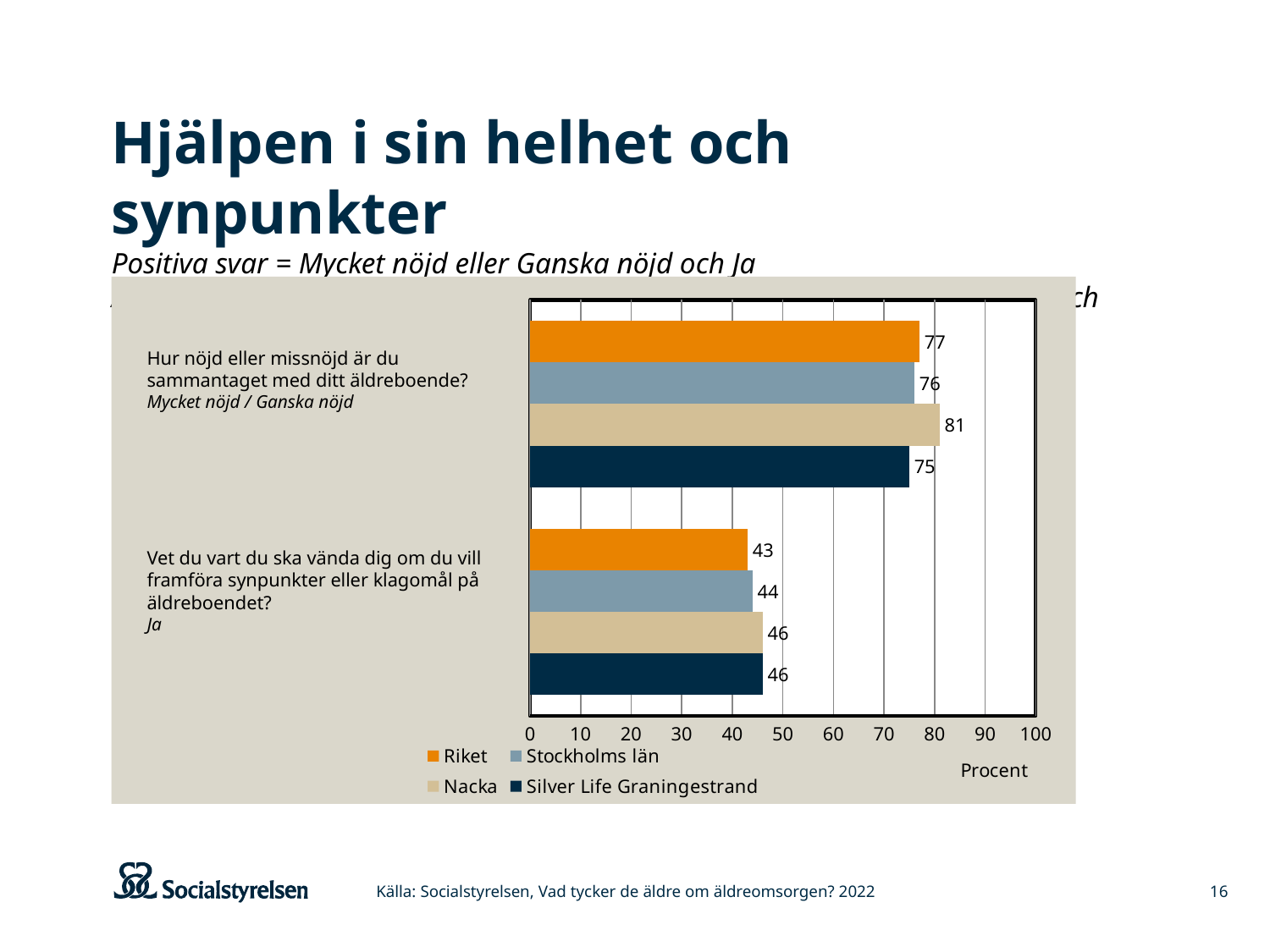
What is the difference between the Nacka value and the Silver Life Graningestrand value on the question "Hur nöjd eller missnöjd är du sammantaget med ditt äldreboende?"? 6 How many question categories are shown on the chart? 2 Which is larger on the question "Hur nöjd eller missnöjd är du sammantaget med ditt äldreboende?": the value for Riket or the value for Silver Life Graningestrand? Riket How many series does the legend list? 4 Which series has the highest value on the question "Hur nöjd eller missnöjd är du sammantaget med ditt äldreboende?"? Nacka What is the value for Stockholms län on the question "Vet du vart du ska vända dig om du vill framföra synpunkter eller klagomål på äldreboendet?"? 44 What is the value for Nacka on the question "Hur nöjd eller missnöjd är du sammantaget med ditt äldreboende?"? 81 Which series has the lowest value on the question "Vet du vart du ska vända dig om du vill framföra synpunkter eller klagomål på äldreboendet?"? Riket What is the value for Riket on the question "Vet du vart du ska vända dig om du vill framföra synpunkter eller klagomål på äldreboendet?"? 43 What is the value for Silver Life Graningestrand on the question "Hur nöjd eller missnöjd är du sammantaget med ditt äldreboende?"? 75 What is the label on the horizontal axis of the chart? Procent What kind of chart is shown on the slide? bar chart